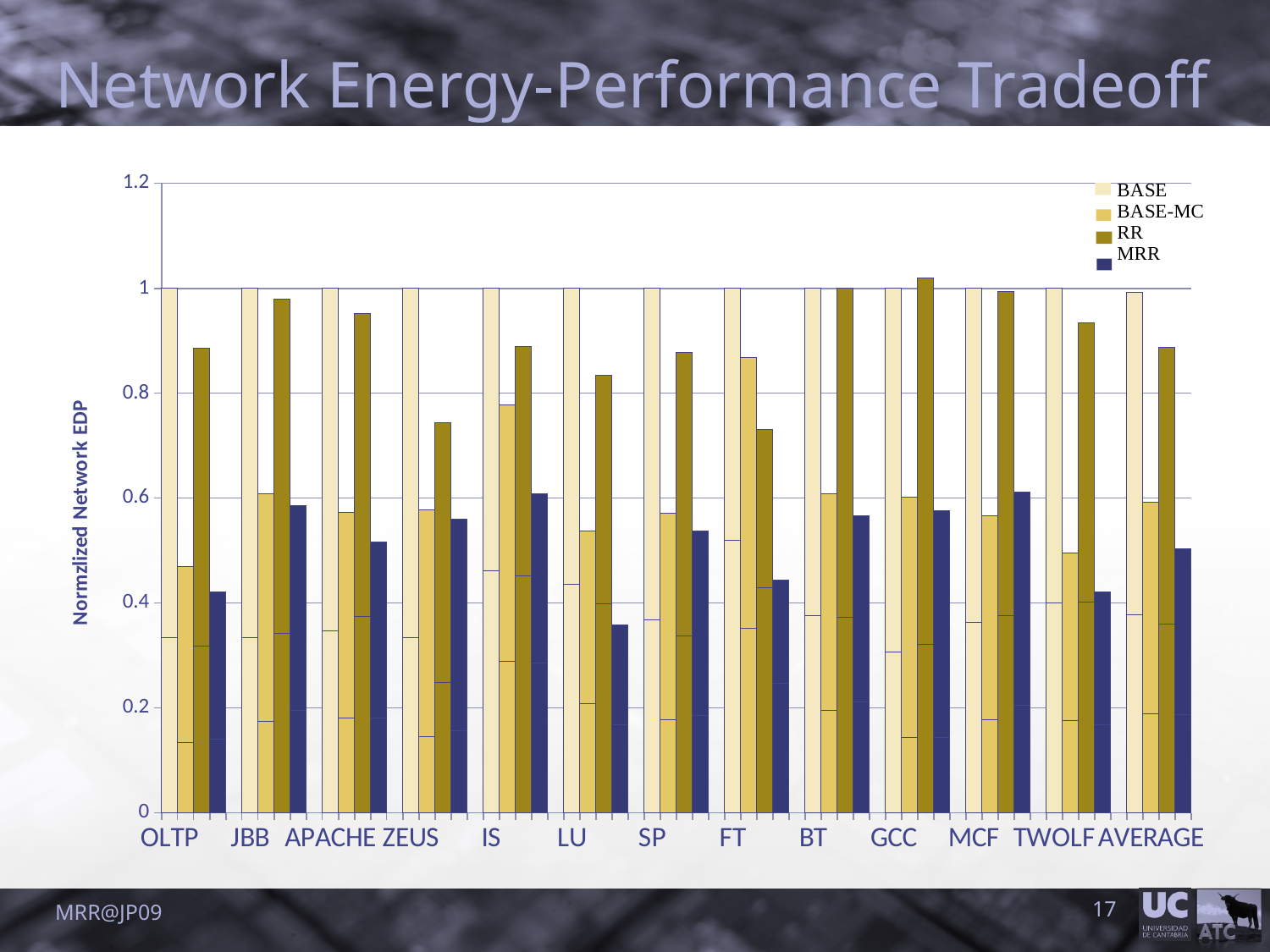
Is the RR value for GCC greater or less than 1? greater How many categories are shown along the x axis? 13 How many series does the legend list? 4 Is the BASE-MC value for FT greater or less than 0.8? greater What is the BASE value for OLTP? 1 What is the title of the chart's vertical axis? Normzlized Network EDP For FT, which is larger: the BASE-MC value or the RR value? BASE-MC Is the MRR value for LU greater or less than 0.4? less Which is larger: the MRR value for IS or the MRR value for LU? IS Which category has the lowest MRR value? LU What kind of chart is shown on the slide? bar chart